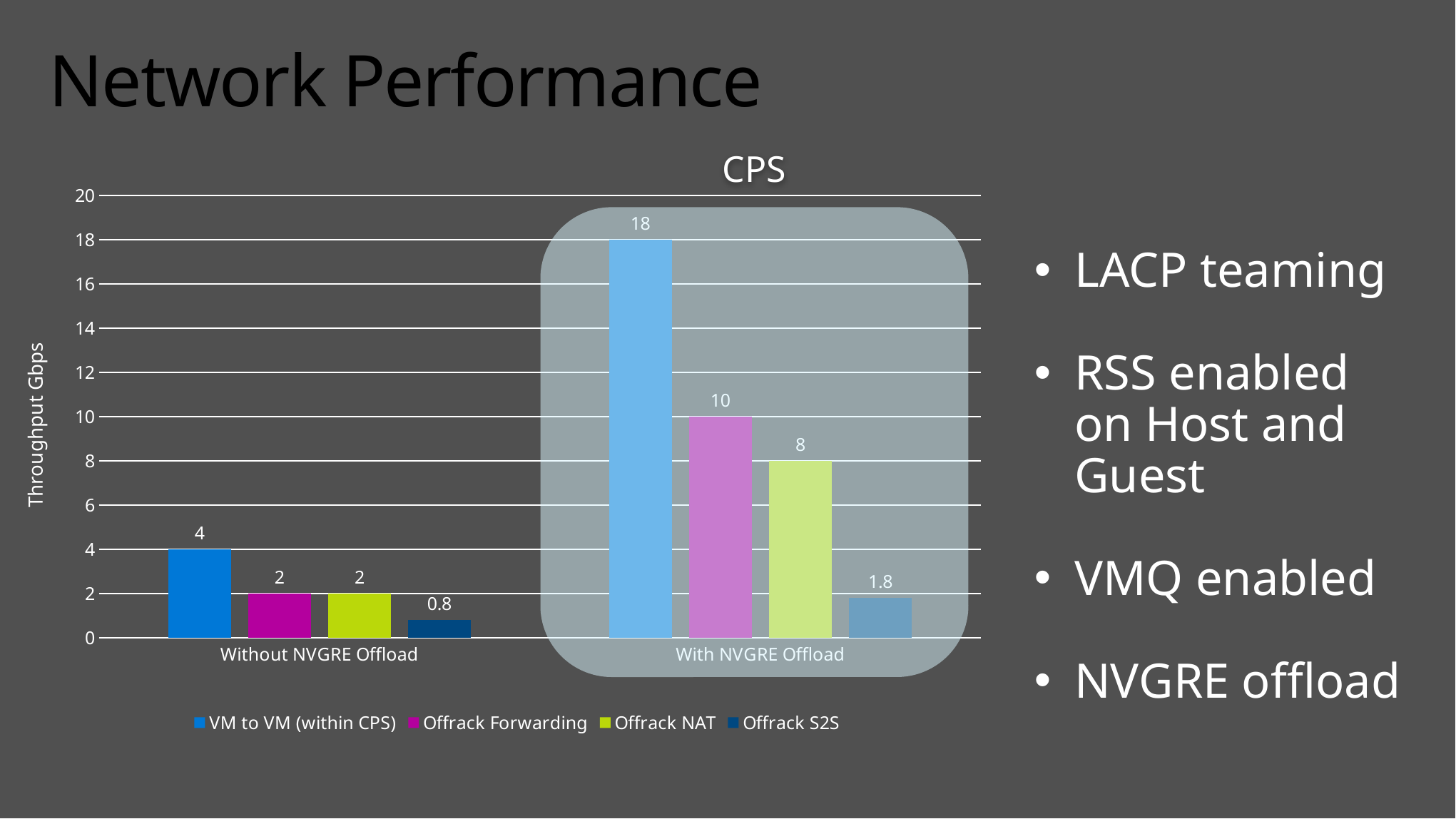
Which series has the highest throughput with NVGRE Offload? VM to VM (within CPS) Which series has the lowest throughput without NVGRE Offload? Offrack S2S What is the label of the vertical axis? Throughput Gbps How many categories are shown on the x axis? 2 What is the throughput for Offrack NAT without NVGRE Offload? 2 How many series does the legend list? 4 What is the difference in throughput for VM to VM (within CPS) between With NVGRE Offload and Without NVGRE Offload? 14 What is the throughput for Offrack Forwarding with NVGRE Offload? 10 What is the throughput for Offrack S2S without NVGRE Offload? 0.8 What kind of chart is shown on the slide? Bar chart Which is larger: Offrack NAT with NVGRE Offload or Offrack Forwarding with NVGRE Offload? Offrack Forwarding with NVGRE Offload What is the throughput for VM to VM (within CPS) with NVGRE Offload? 18